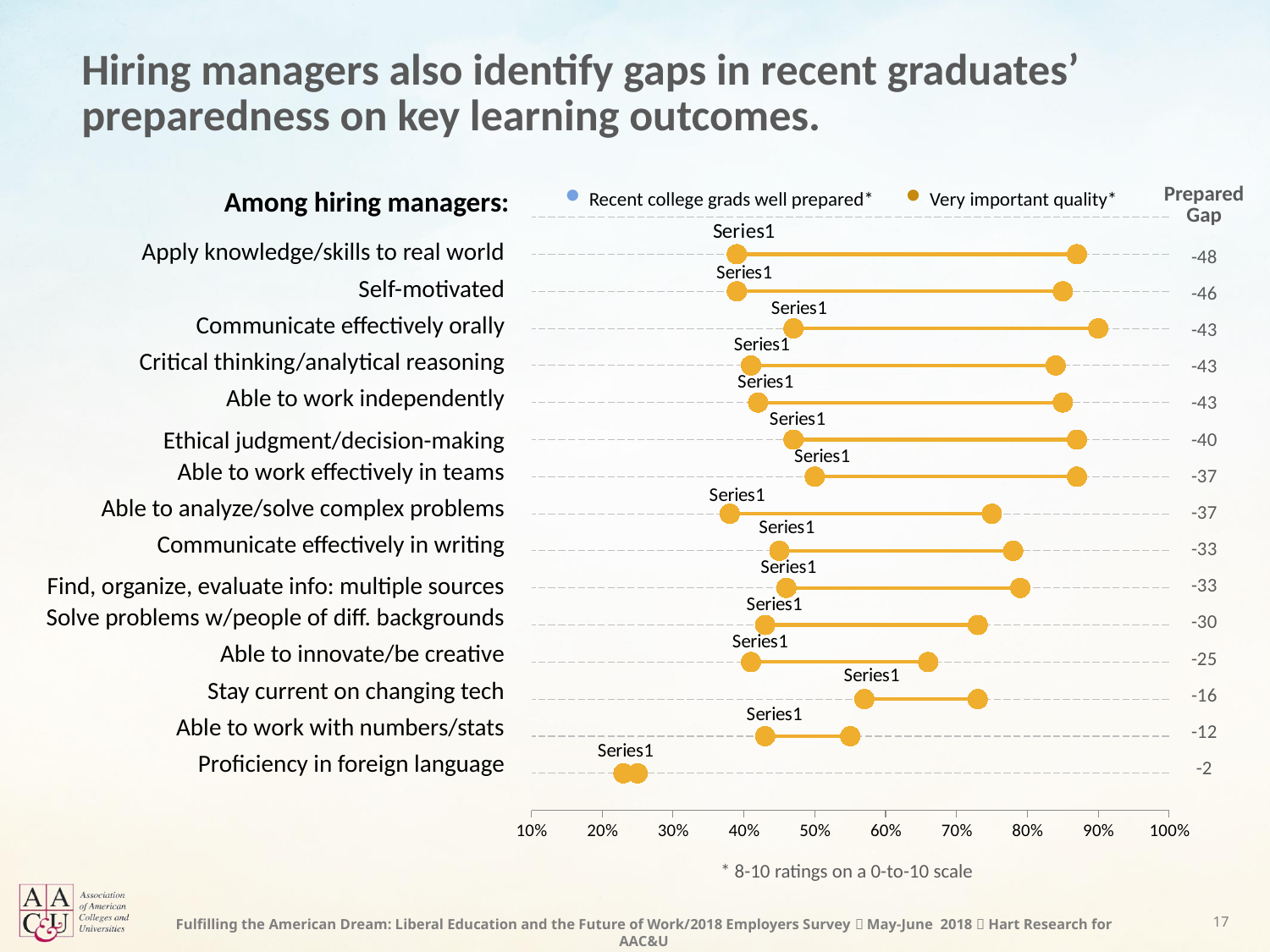
What is the difference between the Prepared Gap for "Self-motivated" and the Prepared Gap for "Stay current on changing tech"? 30 Which learning outcome has the largest Prepared Gap? Apply knowledge/skills to real world What is the Prepared Gap value for "Proficiency in foreign language"? -2 What is the Prepared Gap value for "Apply knowledge/skills to real world"? -48 How many learning outcomes are listed on the chart? 15 What is the Prepared Gap value for "Ethical judgment/decision-making"? -40 Is the "Very important quality" value for "Apply knowledge/skills to real world" greater or less than 80%? greater Which has the larger Prepared Gap: "Communicate effectively in writing" or "Able to innovate/be creative"? Communicate effectively in writing Is the "Very important quality" value for "Proficiency in foreign language" greater or less than 30%? less What does the footnote below the chart say the asterisk means? 8-10 ratings on a 0-to-10 scale Which learning outcome has the smallest Prepared Gap? Proficiency in foreign language How many series does the chart legend list? 2